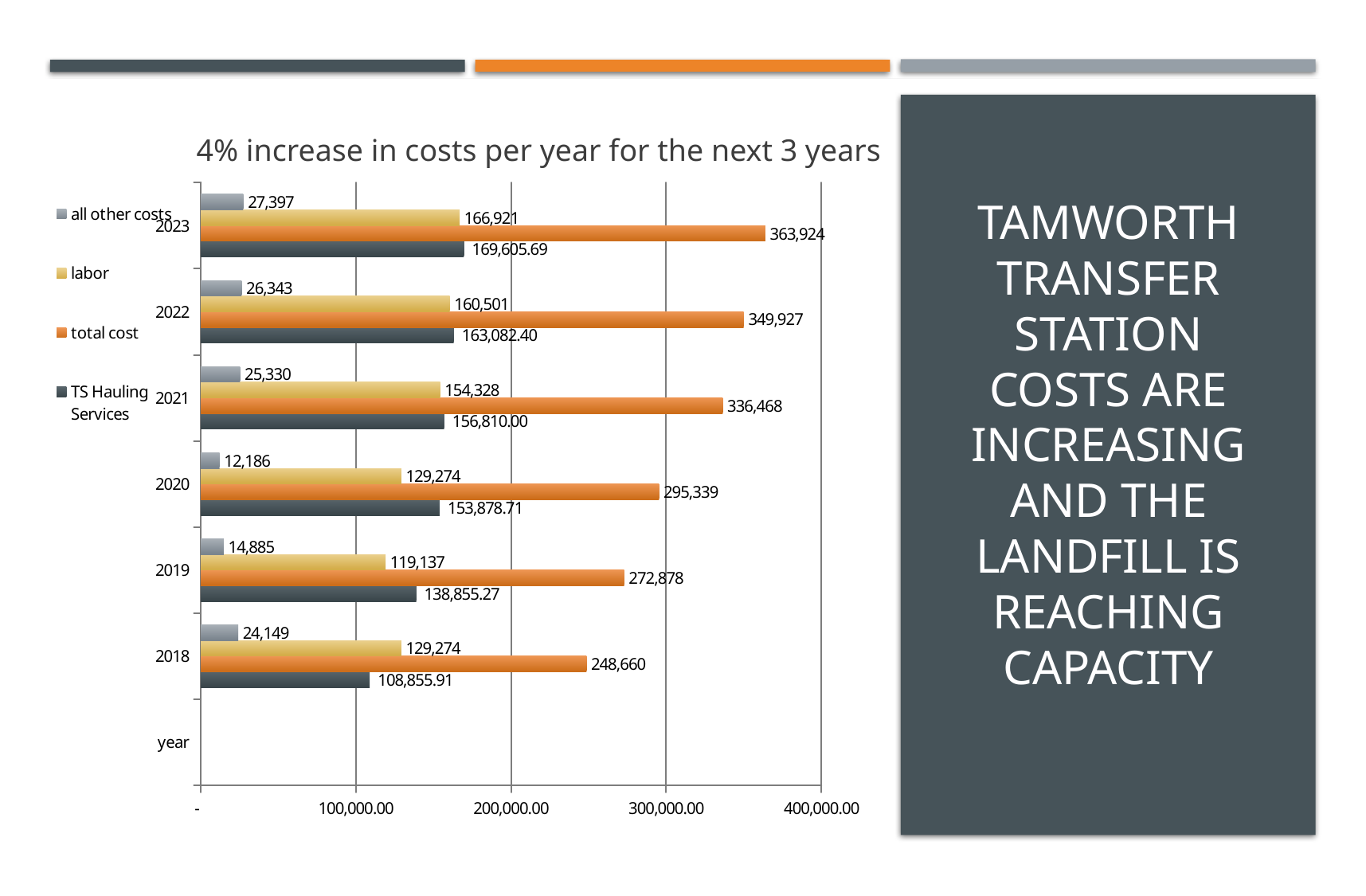
What is the total cost for 2021? 336,468 What is the difference between the total cost for 2023 and the total cost for 2022? 13,997 Is the total cost for 2019 greater or less than 300,000.00? less In 2020, which is larger: the TS Hauling Services value or the labor value? TS Hauling Services What is the TS Hauling Services value for 2018? 108,855.91 Does the total cost rise or fall from 2018 to 2023? rise Which year has the lowest value for all other costs? 2020 What is the labor cost for 2019? 119,137 What kind of chart is shown on the slide? bar chart What is the value of all other costs for 2020? 12,186 How many series does the legend list? 4 Which year has the highest total cost? 2023